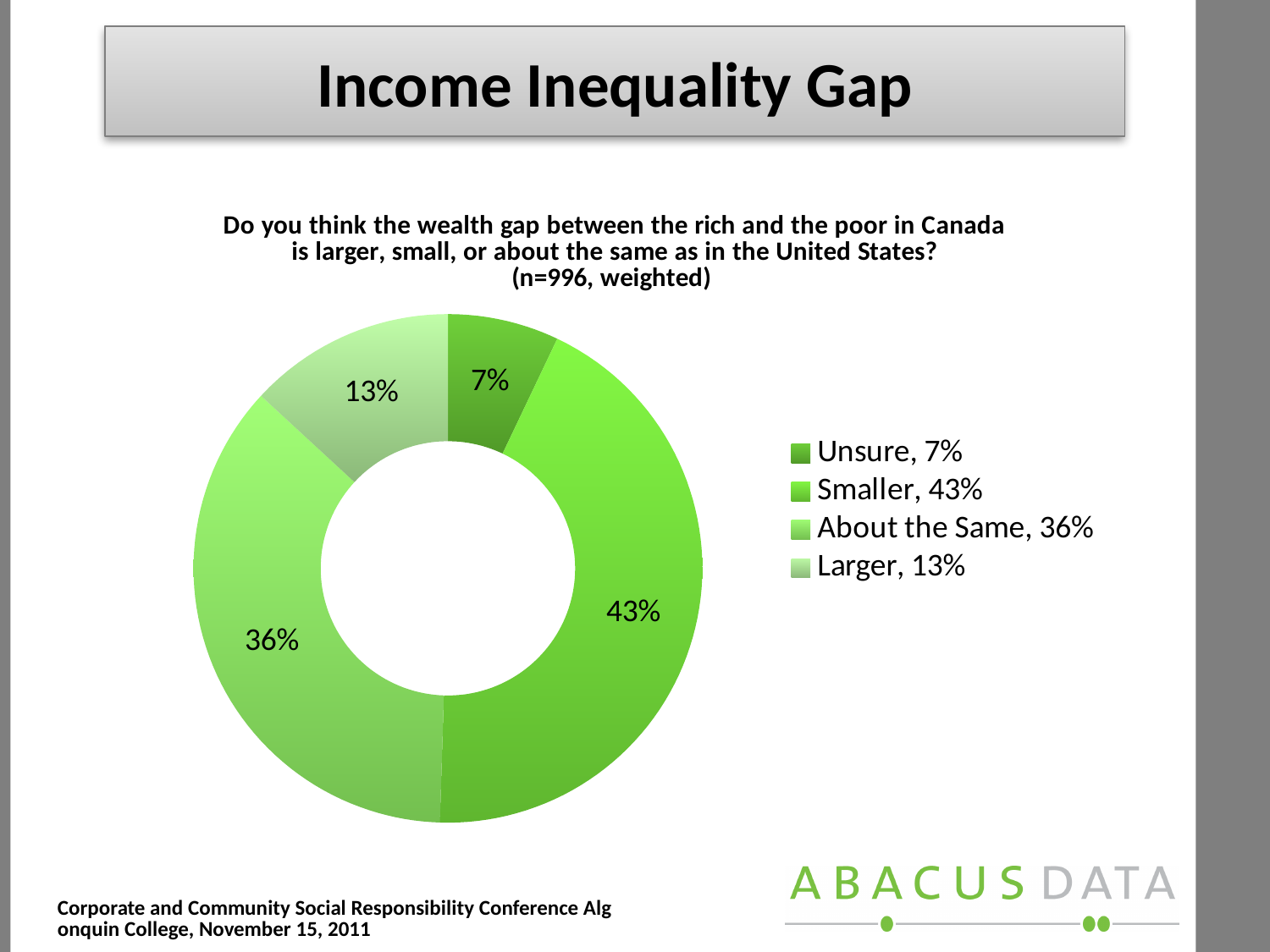
Which response category has the largest share? Smaller What kind of chart is shown on the slide? Doughnut (pie) chart What percentage of respondents said the wealth gap in Canada is smaller than in the United States? 43% What percentage of respondents said the gap is larger in Canada? 13% Which is larger: the share for 'Larger' or the share for 'About the Same'? About the Same Which response category has the smallest share? Unsure What percentage of respondents were unsure? 7% What is the difference in percentage points between 'Larger' and 'Unsure'? 6 What percentage of respondents answered 'About the Same'? 36% What is the sample size stated in the chart title? n=996, weighted How many response categories are shown in the chart? 4 What is the difference in percentage points between 'Smaller' and 'About the Same'? 7